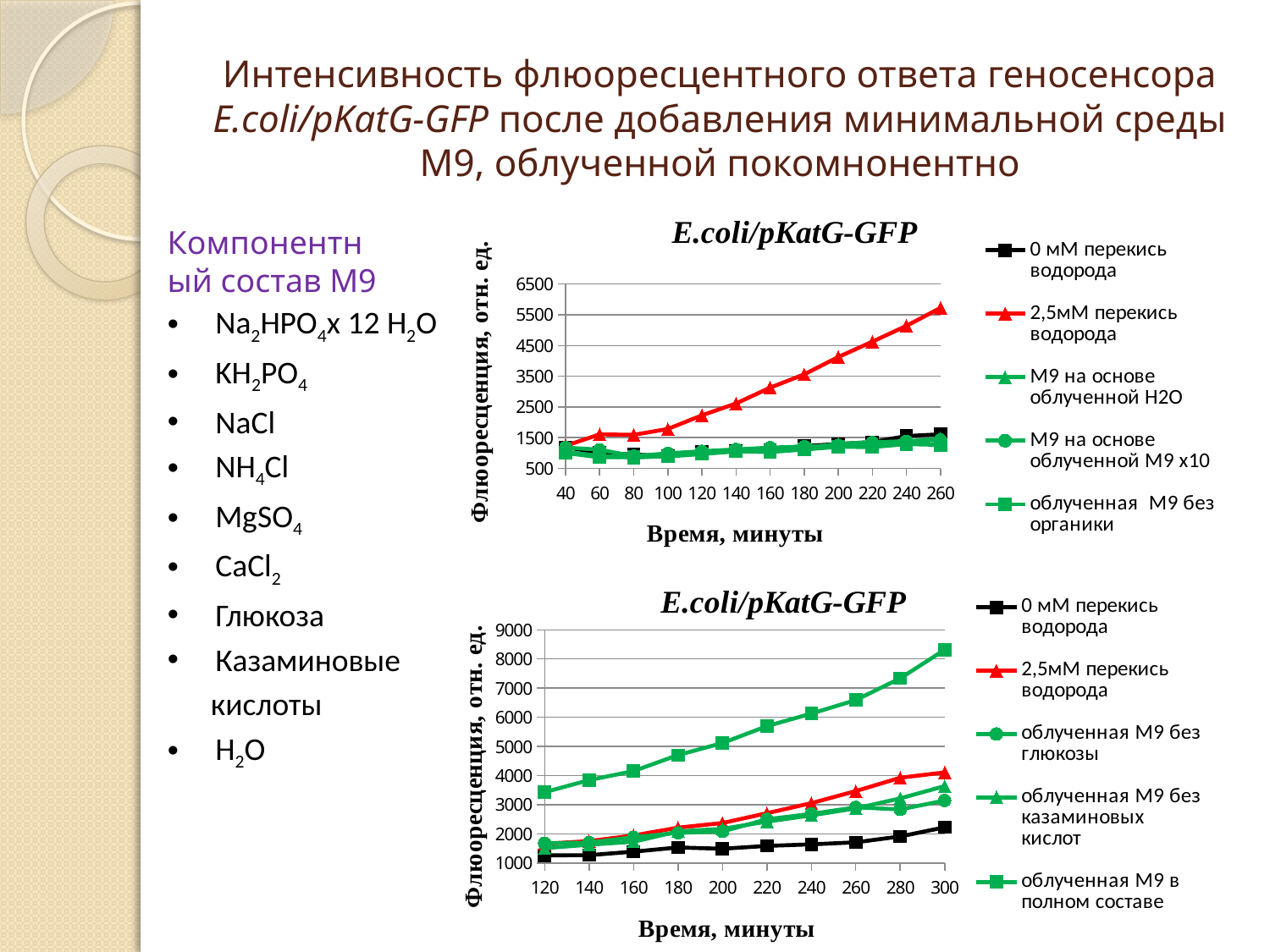
What kind of chart is the top chart on the slide? line chart In the bottom chart, is the value of 'облученная М9 в полном составе' at 300 minutes greater or less than 7000? greater In the bottom chart, which series has the lowest value at 300 minutes? 0 мМ перекись водорода How many series does the legend of the top chart list? 5 How many series does the legend of the bottom chart list? 5 How many time points are plotted along the x axis of the top chart? 12 How many time points are plotted along the x axis of the bottom chart? 10 In the top chart, at 260 minutes, which is larger: '2,5мМ перекись водорода' or '0 мМ перекись водорода'? 2,5мМ перекись водорода In the bottom chart, which series has the highest value at 300 minutes? облученная М9 в полном составе What is the x-axis title of the bottom chart? Время, минуты In the top chart, does the series '2,5мМ перекись водорода' rise or fall as time increases? rises In the top chart, is the value of '2,5мМ перекись водорода' at 260 minutes greater or less than 4500? greater